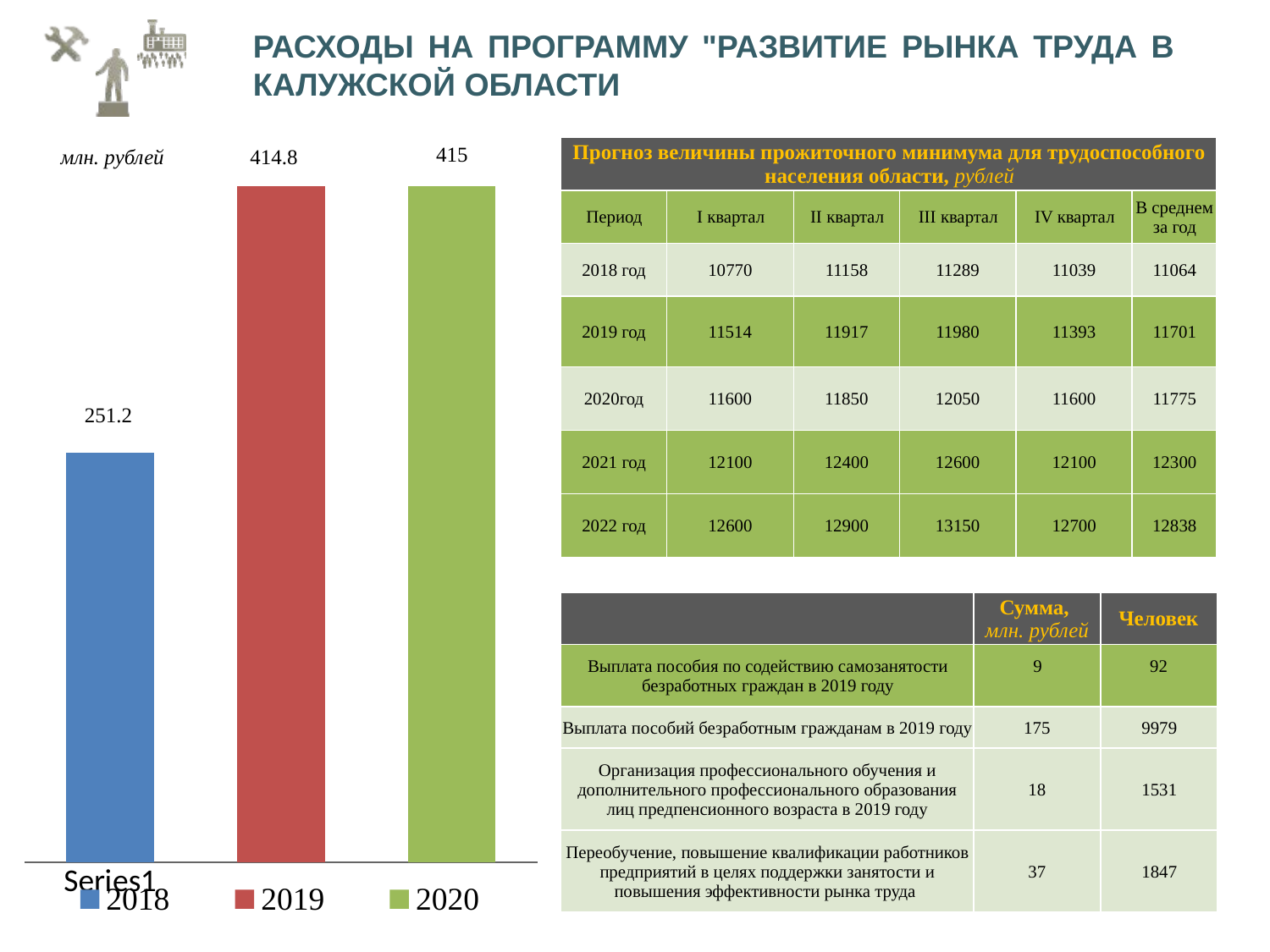
What is the value of the bar for 2020 in the bar chart? 415 What is the value of the bar for 2018 in the bar chart? 251.2 What kind of chart is shown on the left of the slide? bar chart Do the values in the bar chart rise or fall from 2018 to 2020? rise What is the value of the bar for 2019 in the bar chart? 414.8 How many entries does the legend of the bar chart list? 3 What is the difference between the 2020 and 2019 values in the bar chart? 0.2 How many bars are plotted in the bar chart? 3 What is the difference between the 2020 and 2018 values in the bar chart? 163.8 What is the difference between the 2019 and 2018 values in the bar chart? 163.6 Which year has the lowest bar in the bar chart? 2018 In the bar chart, which is larger: the value for 2018 or the value for 2019? 2019